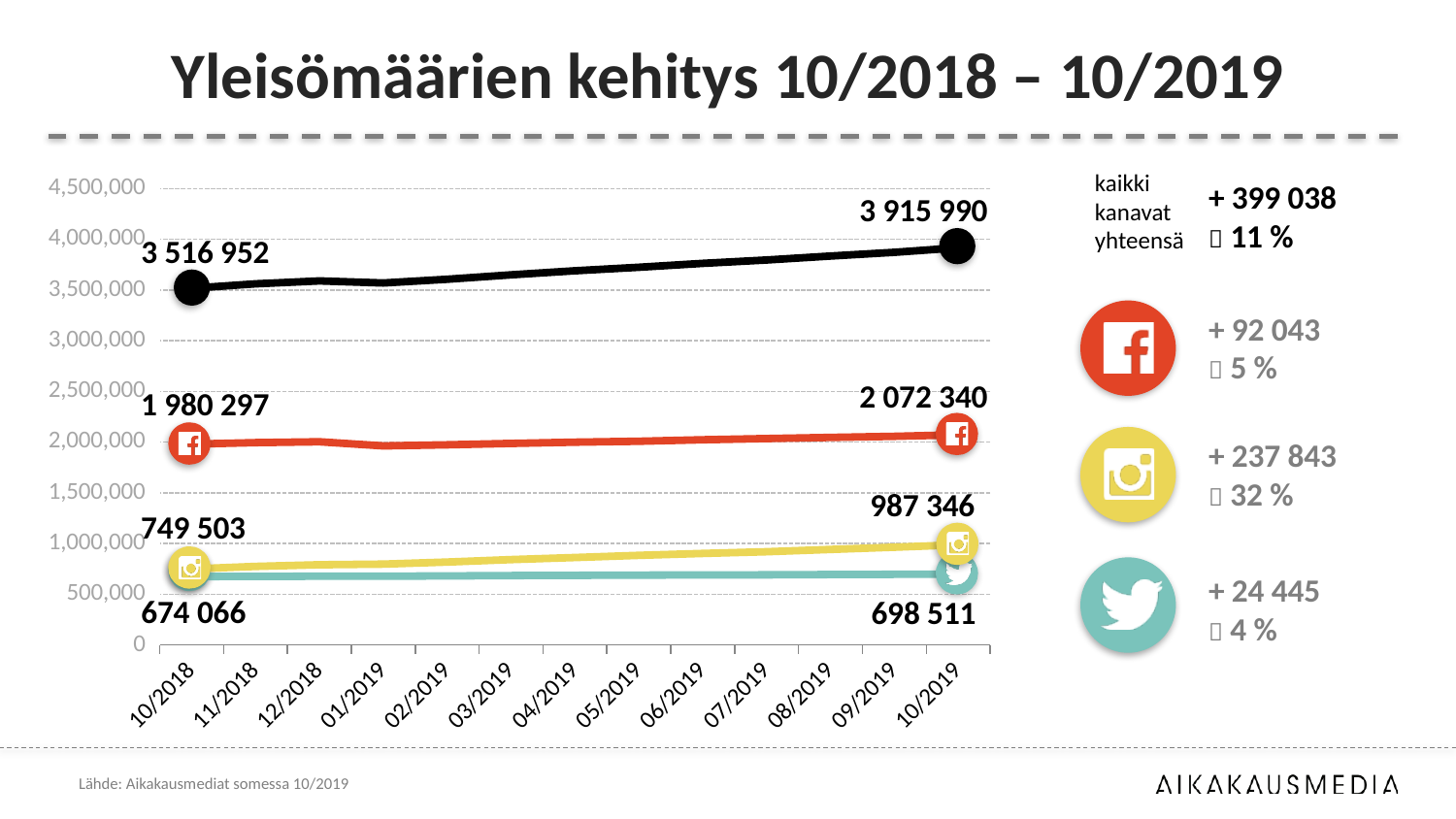
What is the Twitter value at 10/2019? 698 511 How many months (points) are shown on the x axis? 13 What type of chart is shown on the slide? line chart Which channel has the lowest value at 10/2019? Twitter What is the value of the black (total) line at 10/2019? 3 915 990 Does the Instagram line rise or fall from 10/2018 to 10/2019? rise What is the value of the black (total) line at 10/2018? 3 516 952 By how much did the Instagram value grow from 10/2018 to 10/2019? 237 843 By how much did the total (black line) grow from 10/2018 to 10/2019? 399 038 Which channel line has the highest value at 10/2019 (excluding the total)? Facebook What is the Facebook value at 10/2019? 2 072 340 What is the Instagram value at 10/2018? 749 503